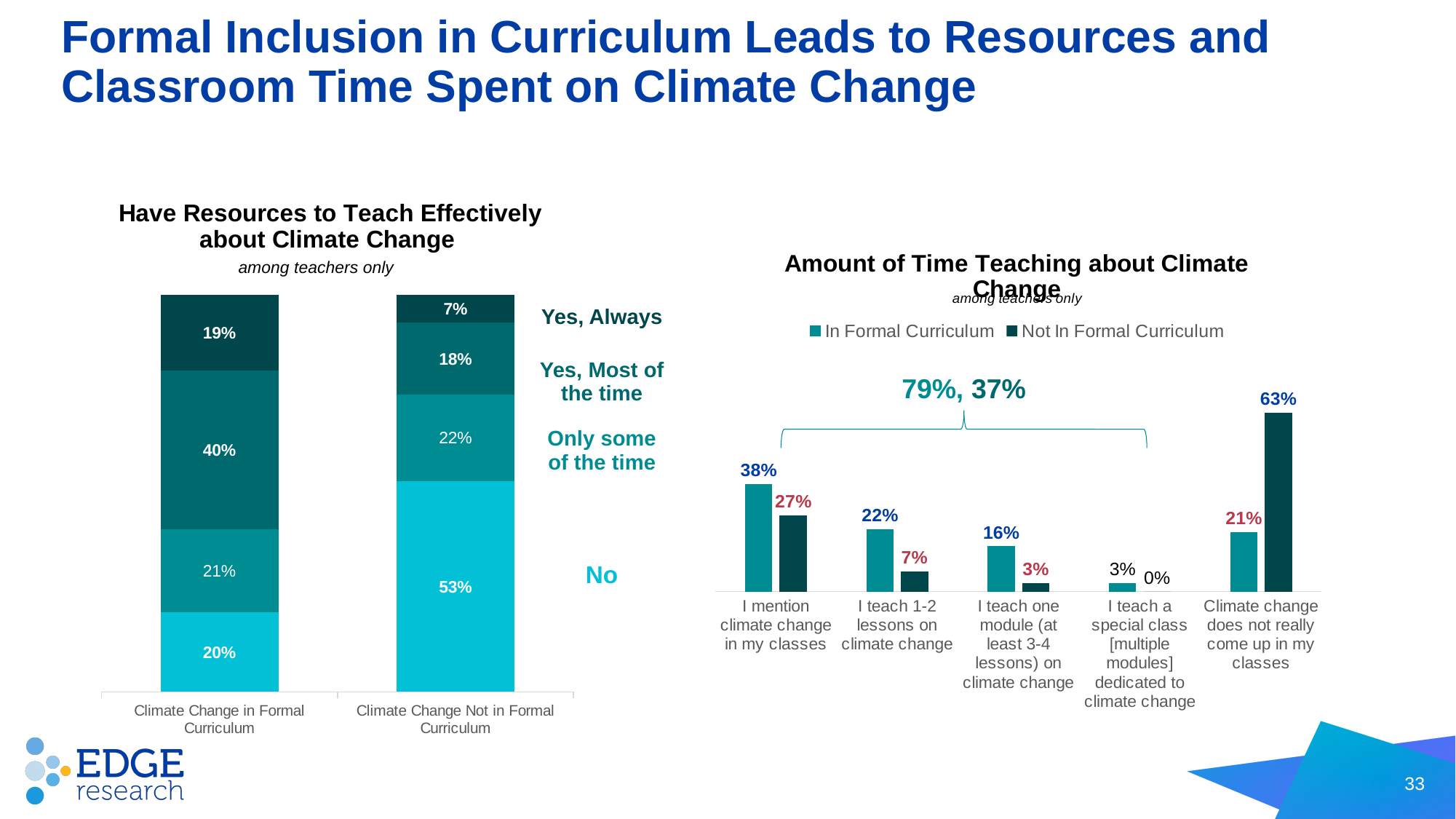
What type of chart is the 'Have Resources to Teach Effectively about Climate Change' chart? Stacked bar chart How many categories are shown on the x axis of the 'Amount of Time Teaching about Climate Change' chart? 5 How many series does the legend of the 'Amount of Time Teaching about Climate Change' chart list? 2 In the 'Amount of Time Teaching about Climate Change' chart, what is the 'In Formal Curriculum' value for 'I mention climate change in my classes'? 38% In the 'Have Resources to Teach Effectively about Climate Change' chart, what percentage of teachers with climate change not in the formal curriculum answered 'No'? 53% In the 'Amount of Time Teaching about Climate Change' chart, which category has the lowest 'Not In Formal Curriculum' value? I teach a special class [multiple modules] dedicated to climate change In the 'Have Resources to Teach Effectively about Climate Change' chart, what percentage of teachers with climate change in the formal curriculum answered 'Yes, Always'? 19% In the 'Have Resources to Teach Effectively about Climate Change' chart, what is the difference between the 'No' shares for the 'Not in Formal Curriculum' and 'in Formal Curriculum' bars? 33 percentage points In the 'Have Resources to Teach Effectively about Climate Change' chart, which bar has the larger 'Yes, Most of the time' segment? Climate Change in Formal Curriculum In the 'Amount of Time Teaching about Climate Change' chart, what is the 'Not In Formal Curriculum' value for 'Climate change does not really come up in my classes'? 63% In the 'Have Resources to Teach Effectively about Climate Change' chart, how many bars are shown? 2 In the 'Amount of Time Teaching about Climate Change' chart, what is the difference between the 'In Formal Curriculum' and 'Not In Formal Curriculum' values for 'I teach 1-2 lessons on climate change'? 15 percentage points